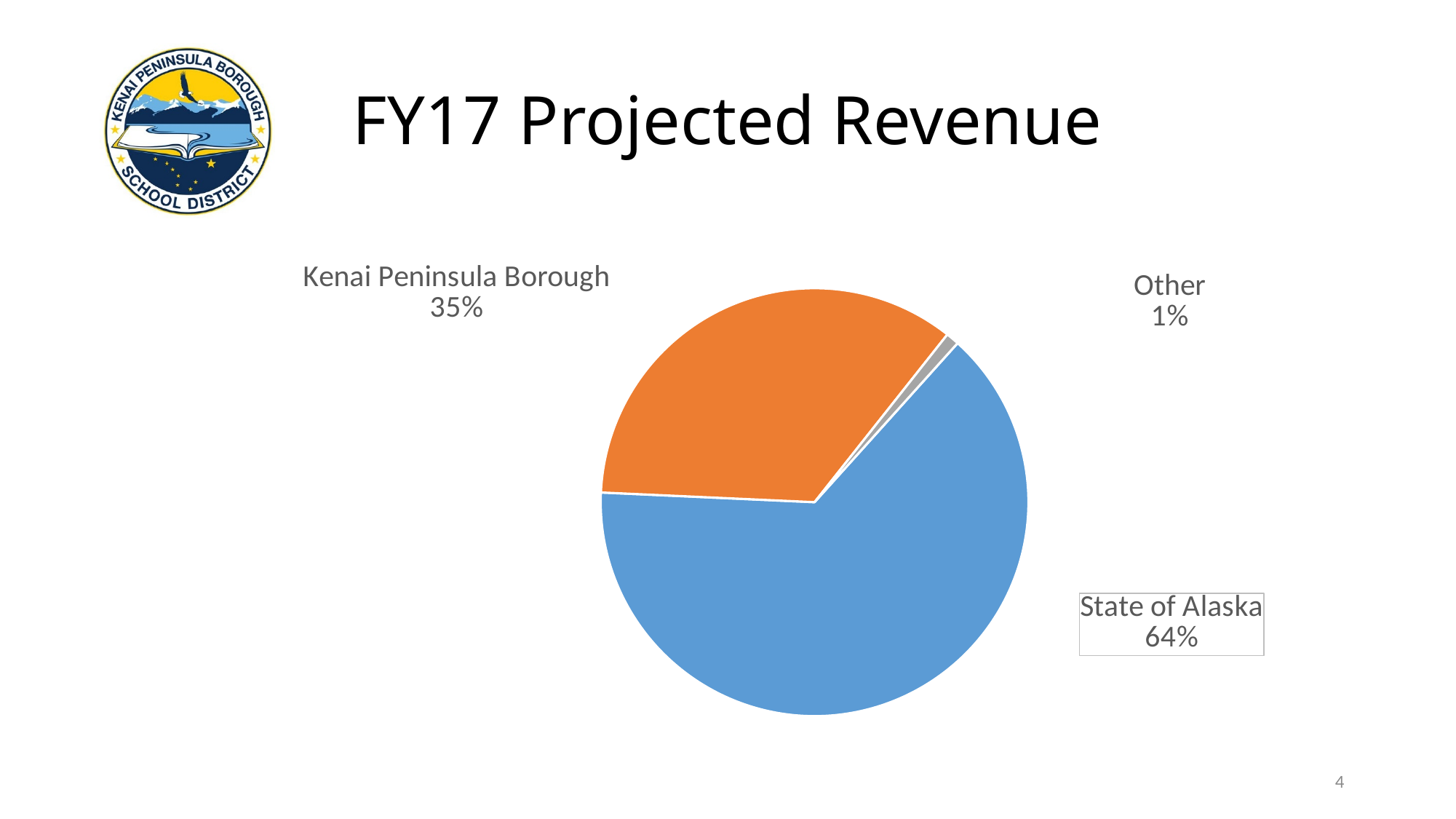
What colour is the State of Alaska slice? Blue Which is larger, the share for Kenai Peninsula Borough or the share for Other? Kenai Peninsula Borough What share of FY17 projected revenue comes from the Kenai Peninsula Borough? 35% What kind of chart is shown on the slide? Pie chart What share of FY17 projected revenue comes from the State of Alaska? 64% What is the combined share of the State of Alaska and Kenai Peninsula Borough slices? 99% What is the title of the slide? FY17 Projected Revenue How many slices does the pie chart have? 3 Which revenue source has the largest share of the pie? State of Alaska What share of FY17 projected revenue is labelled Other? 1% Which revenue source has the smallest share of the pie? Other How many percentage points larger is the State of Alaska share than the Kenai Peninsula Borough share? 29